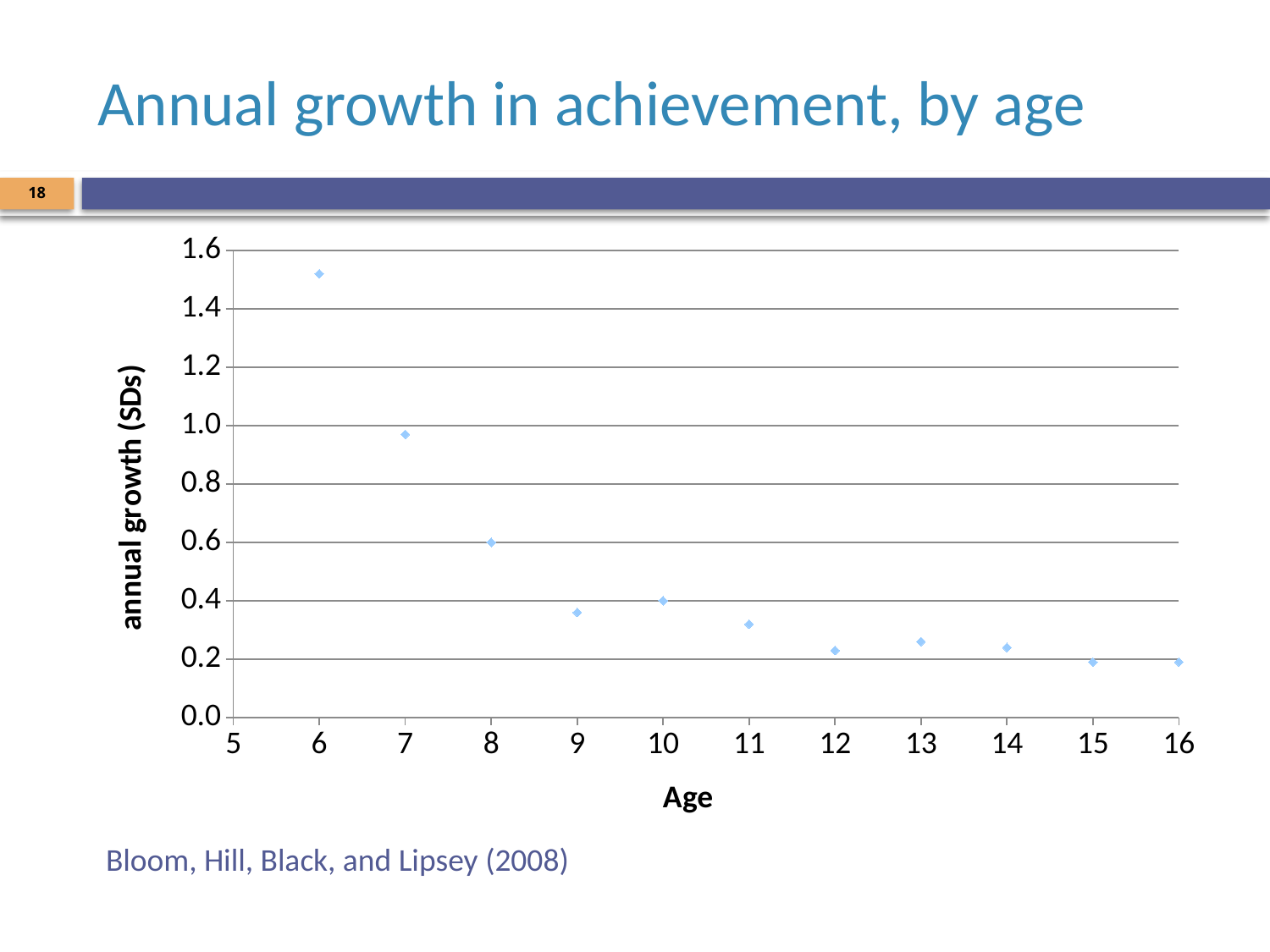
Do the values generally rise or fall as age increases along the x axis? Fall How many data points are plotted on the chart? 11 Is the value for age 6 greater or less than 1.4? greater What kind of chart is shown on the slide? Scatter plot What is the label on the vertical axis? annual growth (SDs) Is the value for age 7 greater or less than 1.0? less Is the value for age 14 greater or less than 0.2? greater At which age is annual growth in achievement highest? 6 What is the label on the horizontal axis? Age Which has the larger annual growth, age 6 or age 7? Age 6 Which has the larger annual growth, age 8 or age 11? Age 8